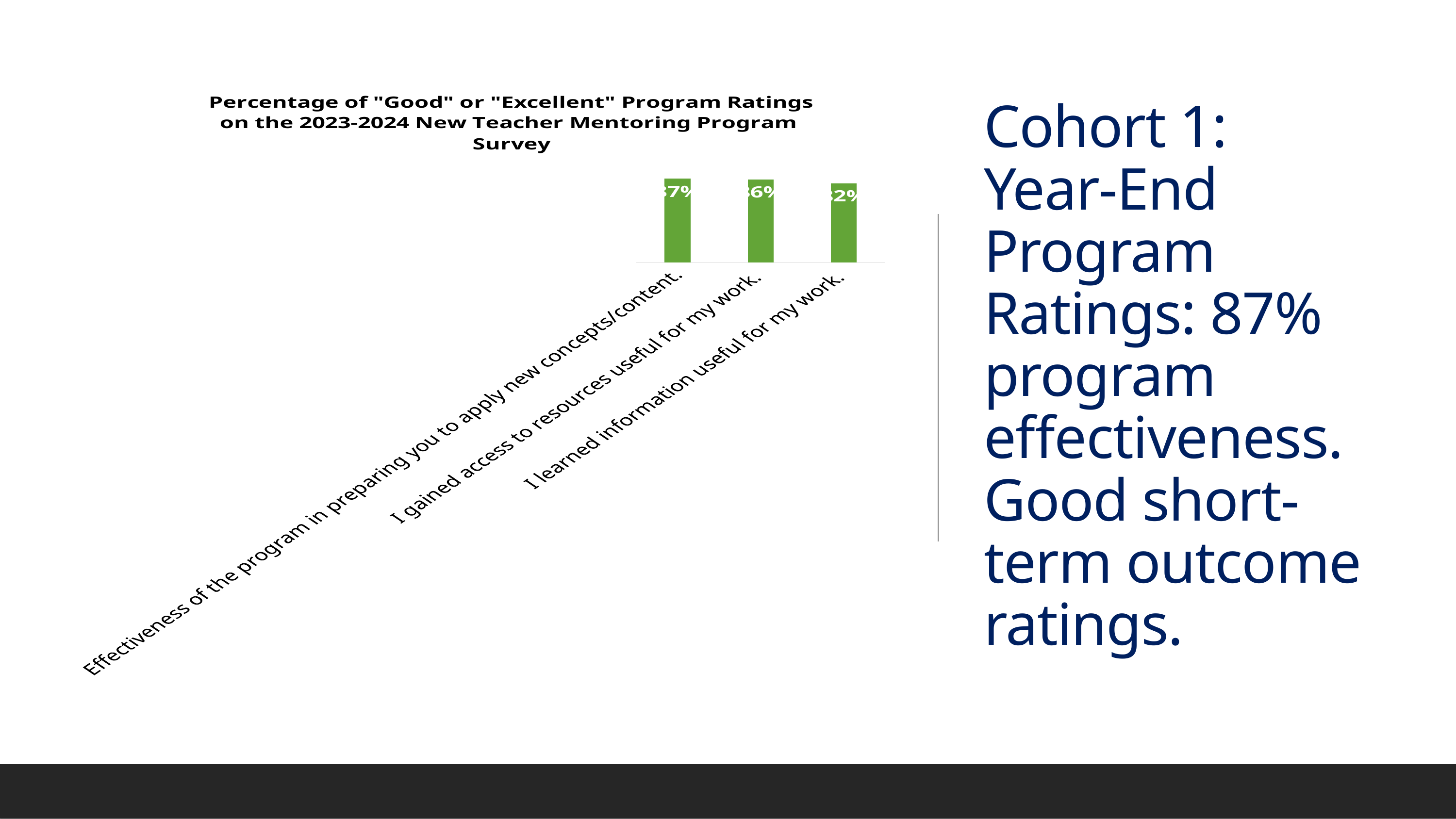
Which category is labelled on the far right of the chart's x axis? I learned information useful for my work. What is the percentage of "Good" or "Excellent" ratings for "Effectiveness of the program in preparing you to apply new concepts/content."? 87% What is the title of the chart? Percentage of "Good" or "Excellent" Program Ratings on the 2023-2024 New Teacher Mentoring Program Survey How many categories (bars) does the chart show? 3 What kind of chart is shown on the slide? bar chart What colour are the bars in the chart? green